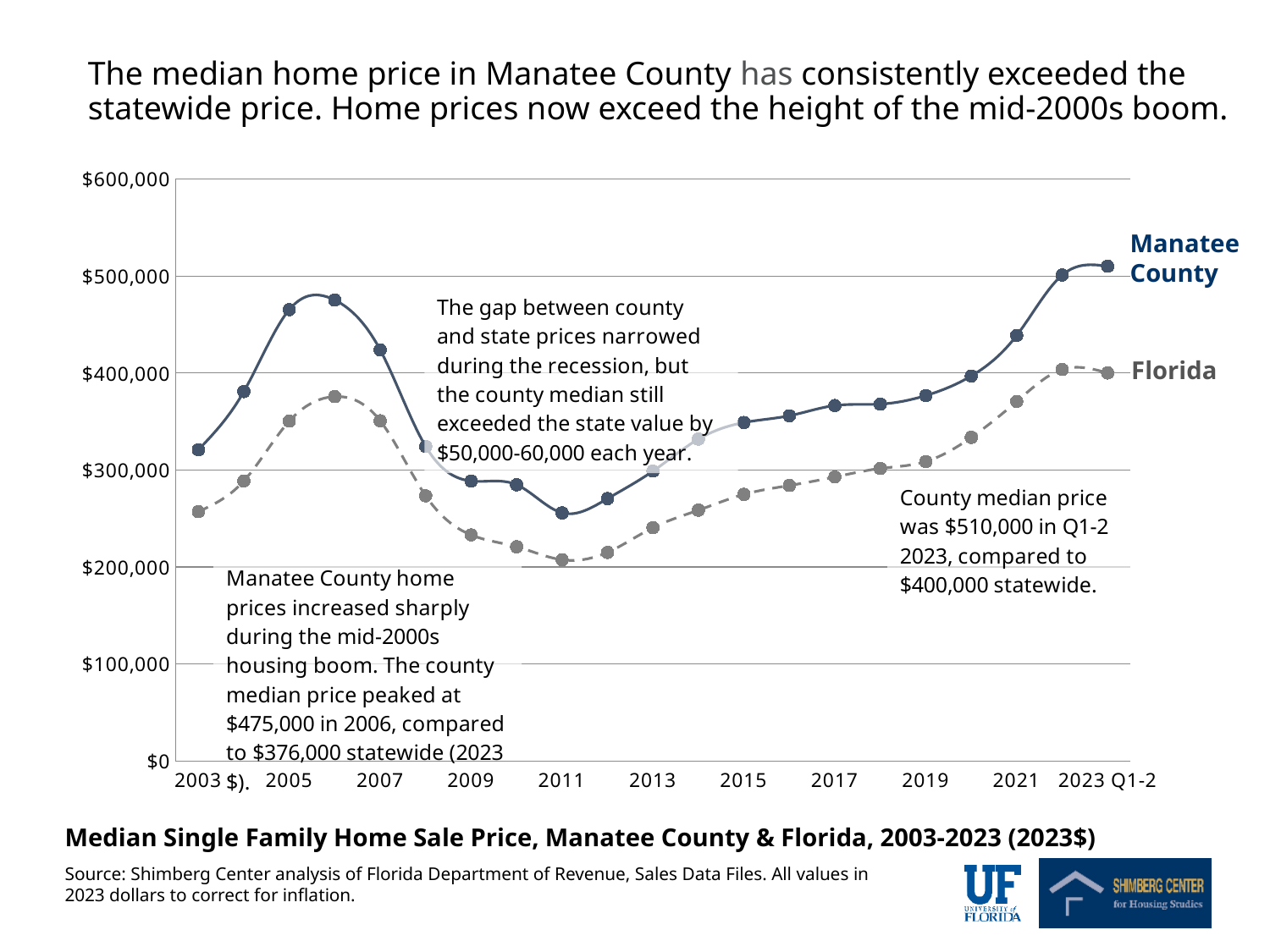
How much higher was the Manatee County median price than the Florida median price in Q1-2 2023? $110,000 What was the Manatee County median home price in 2006, according to the chart annotation? $475,000 Which series has the higher value in 2021, Manatee County or Florida? Manatee County Is the Manatee County value for 2021 greater or less than $400,000? greater How much higher was the Manatee County median price than the statewide price in 2006? $99,000 What was the statewide (Florida) median home price in 2006, according to the chart annotation? $376,000 Does the Manatee County line rise or fall between 2006 and 2011? Fall In which year does the Manatee County line reach its lowest point? 2011 What type of chart is shown on the slide? Line chart What was the Florida median home price in Q1-2 2023? $400,000 How many series are plotted in the chart? 2 What was the Manatee County median home price in Q1-2 2023? $510,000